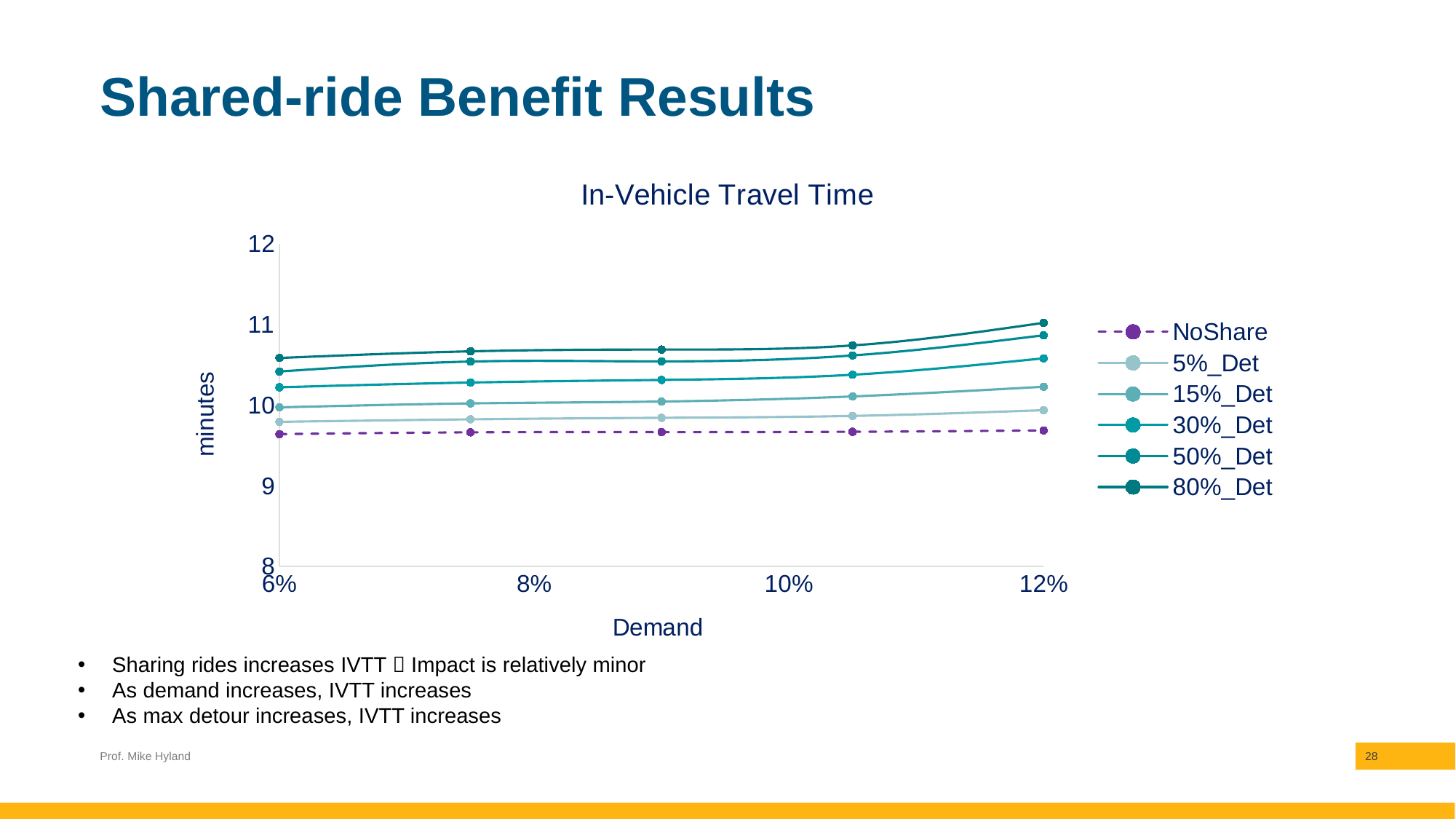
How many series does the legend list? 6 Is the value for 80%_Det at 6% demand greater or less than 11 minutes? less Is the value for 50%_Det at 6% demand greater or less than 10 minutes? greater Does the 80%_Det series rise or fall as demand increases from 6% to 12%? rise What is the title of the chart? In-Vehicle Travel Time Which series has the lowest in-vehicle travel time across the demand range? NoShare Is the value for NoShare at 6% demand greater or less than 10 minutes? less Which series has the highest in-vehicle travel time at 12% demand? 80%_Det How many data points are plotted for the 80%_Det series? 5 At 12% demand, which is larger: the value for 80%_Det or the value for NoShare? 80%_Det What kind of chart is shown on the slide? line chart